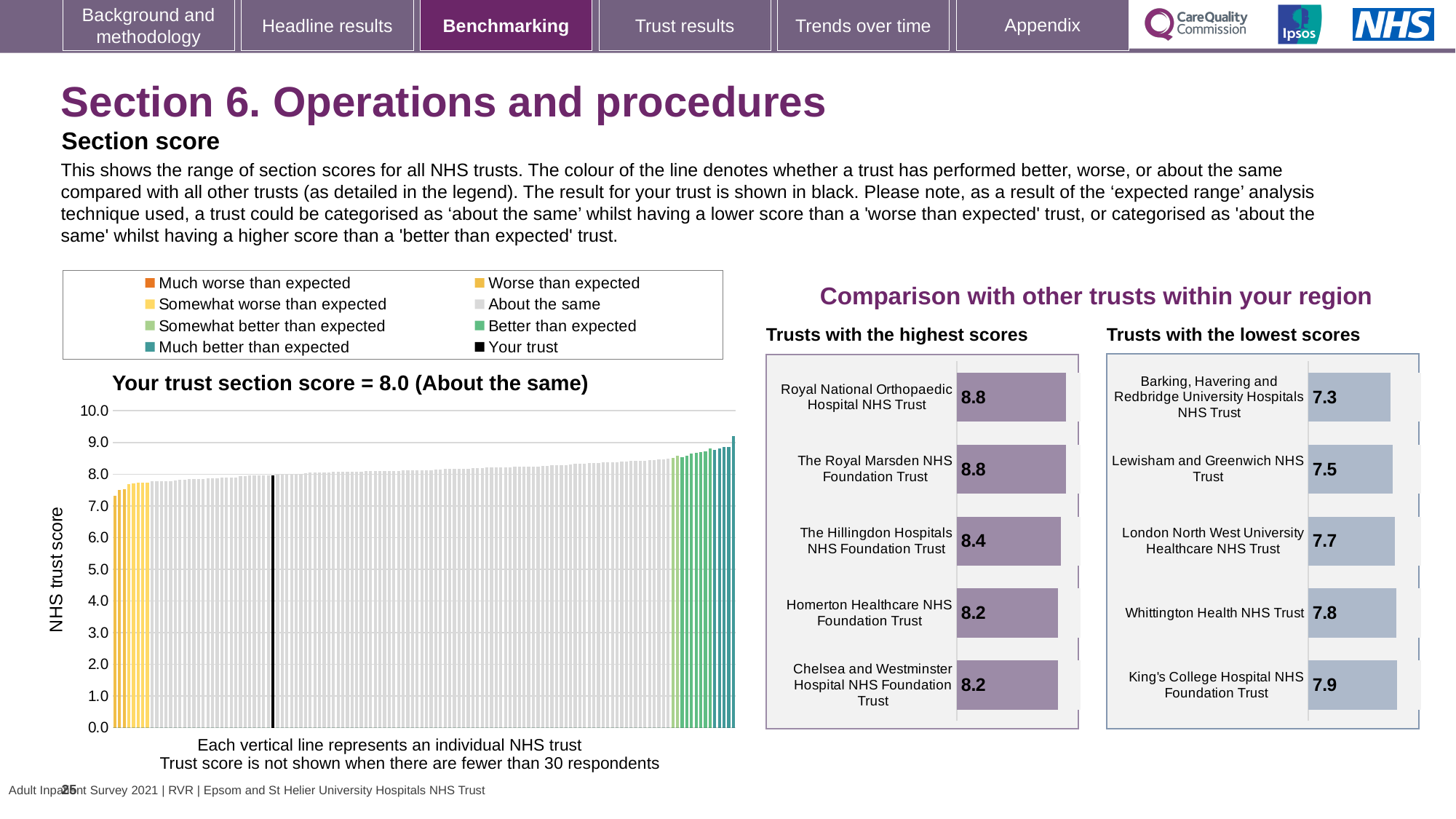
On the 'Trusts with the highest scores' chart, what is the difference between the scores of Royal National Orthopaedic Hospital NHS Trust and The Hillingdon Hospitals NHS Foundation Trust? 0.4 How many entries does the legend above the 'Your trust section score' chart list? 8 On the 'Trusts with the highest scores' chart, what is the score for The Hillingdon Hospitals NHS Foundation Trust? 8.4 What kind of chart is the 'Your trust section score' chart? bar chart On the 'Trusts with the lowest scores' chart, which has the larger score: Lewisham and Greenwich NHS Trust or Whittington Health NHS Trust? Whittington Health NHS Trust On the 'Your trust section score' chart, do the bars rise or fall from left to right? rise On the 'Trusts with the lowest scores' chart, which trust has the lowest score? Barking, Havering and Redbridge University Hospitals NHS Trust On the 'Your trust section score' chart, what is the label of the vertical axis? NHS trust score On the 'Trusts with the lowest scores' chart, which trust has the highest score? King's College Hospital NHS Foundation Trust On the 'Your trust section score' chart, what is the section score for your trust? 8.0 How many trusts are shown on the 'Trusts with the highest scores' chart? 5 On the 'Your trust section score' chart, is the value of the leftmost bar greater or less than 7.0? greater